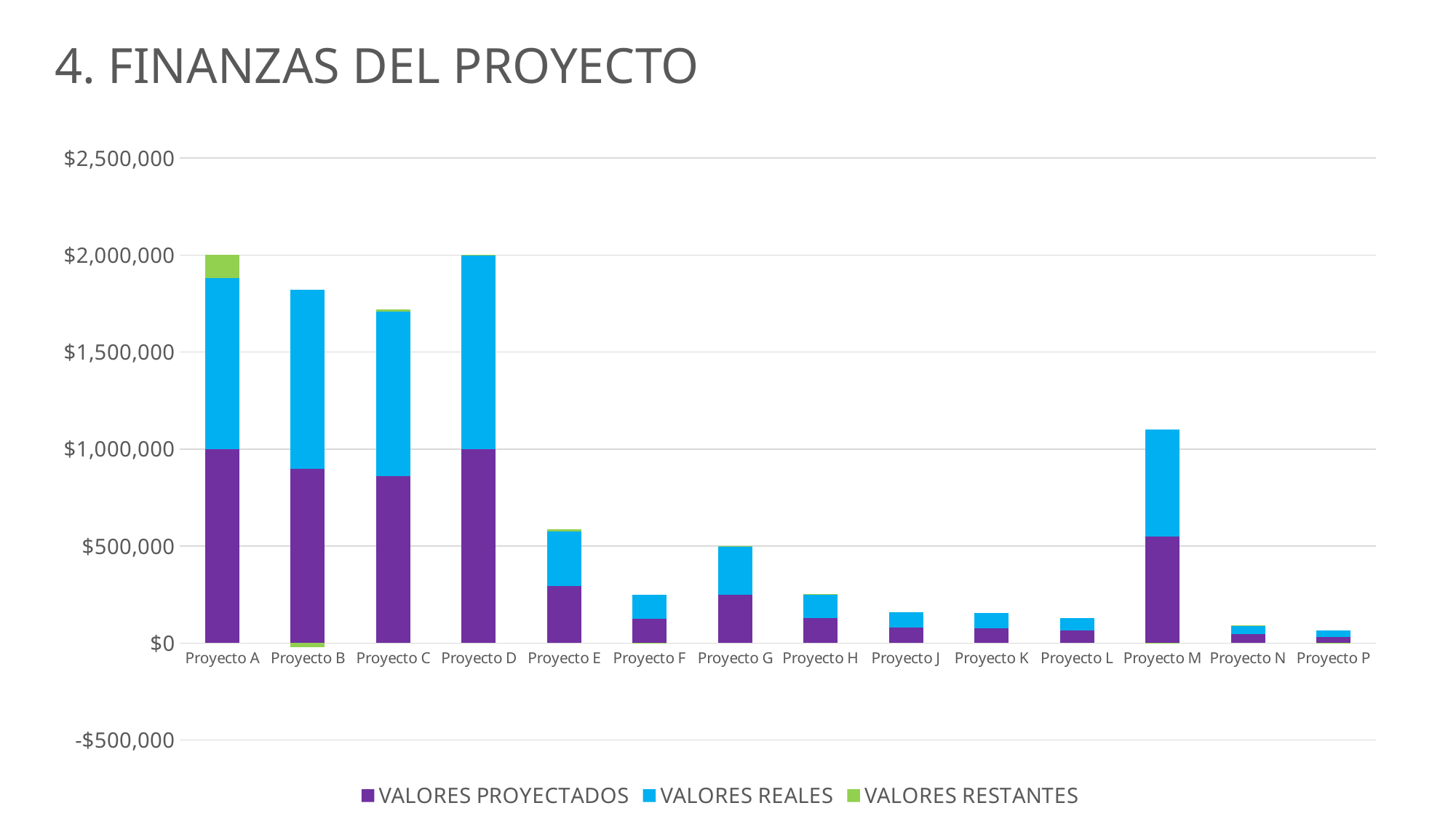
What kind of chart is shown on the slide? Stacked bar chart Which project has the lowest total bar? Proyecto P Is the total bar for Proyecto M greater or less than $1,000,000? greater Which project shows a VALORES RESTANTES segment below $0? Proyecto B How many series does the legend list? 3 Which has the larger VALORES PROYECTADOS value, Proyecto A or Proyecto B? Proyecto A Is the VALORES PROYECTADOS value for Proyecto G greater or less than $500,000? less How many projects (categories) are shown on the x axis? 14 What colour represents VALORES REALES in the legend? Blue Is the total bar for Proyecto B greater or less than $1,500,000? greater Which has the larger total bar, Proyecto M or Proyecto E? Proyecto M